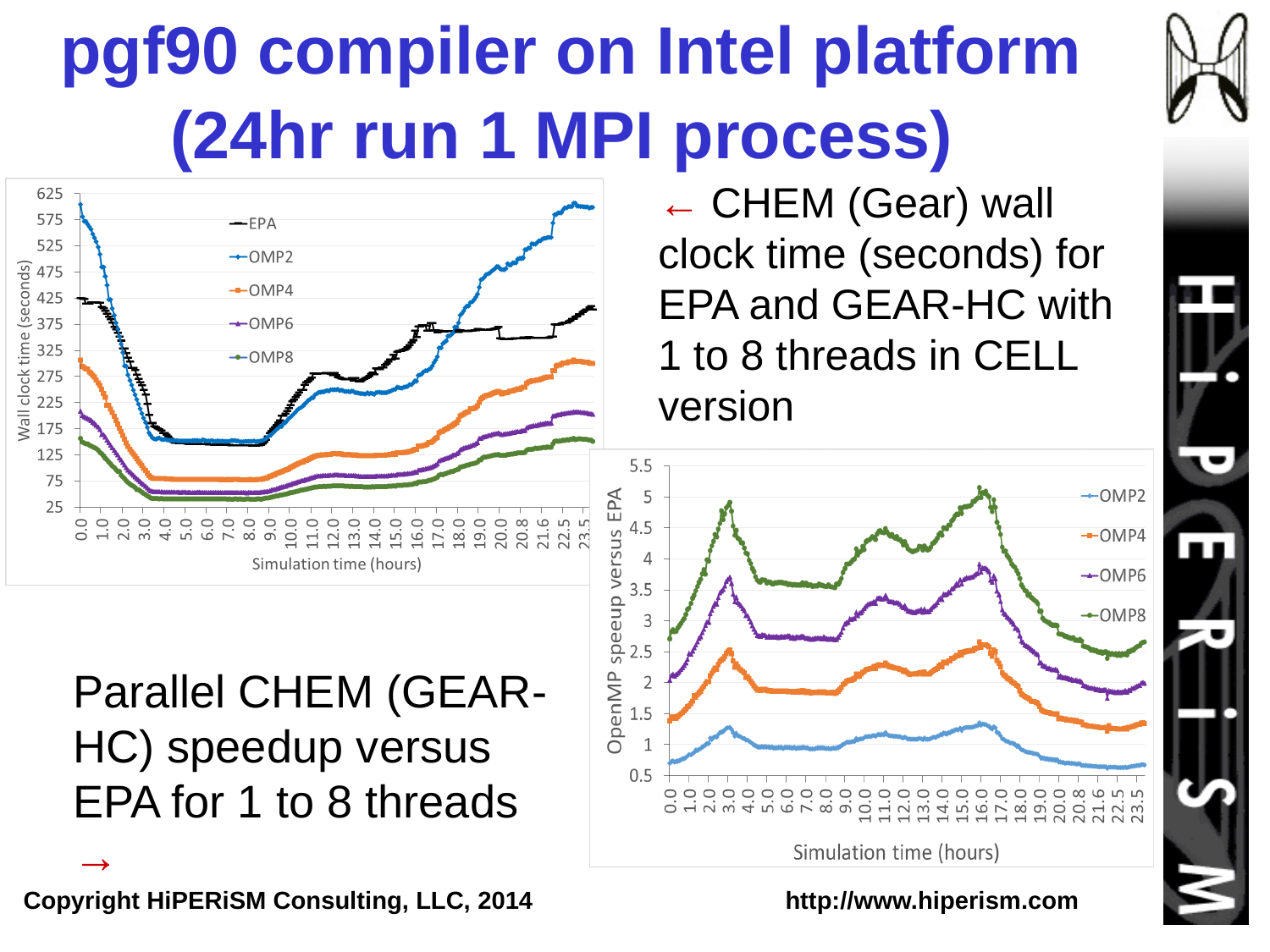
On the top-left chart, how many series does the legend list? 5 On the top-left chart, is the OMP2 value at 0.0 hours greater or less than 575? greater On the top-left chart, is the OMP8 value at 5.0 hours greater or less than 75? less On the top-left chart, which series has the highest wall clock time at 23.5 hours? OMP2 On the bottom-right chart, is the OMP2 value at 0.0 hours greater or less than 1? less What kind of chart is the top-left chart? Line chart What is the y-axis title of the bottom-right chart? OpenMP speeup versus EPA On the bottom-right chart, which series has the highest OpenMP speedup versus EPA? OMP8 On the bottom-right chart, how many series does the legend list? 4 On the top-left chart, which series has the lowest wall clock time across the simulation? OMP8 On the top-left chart, at 0.0 hours, which is larger: the EPA value or the OMP4 value? EPA